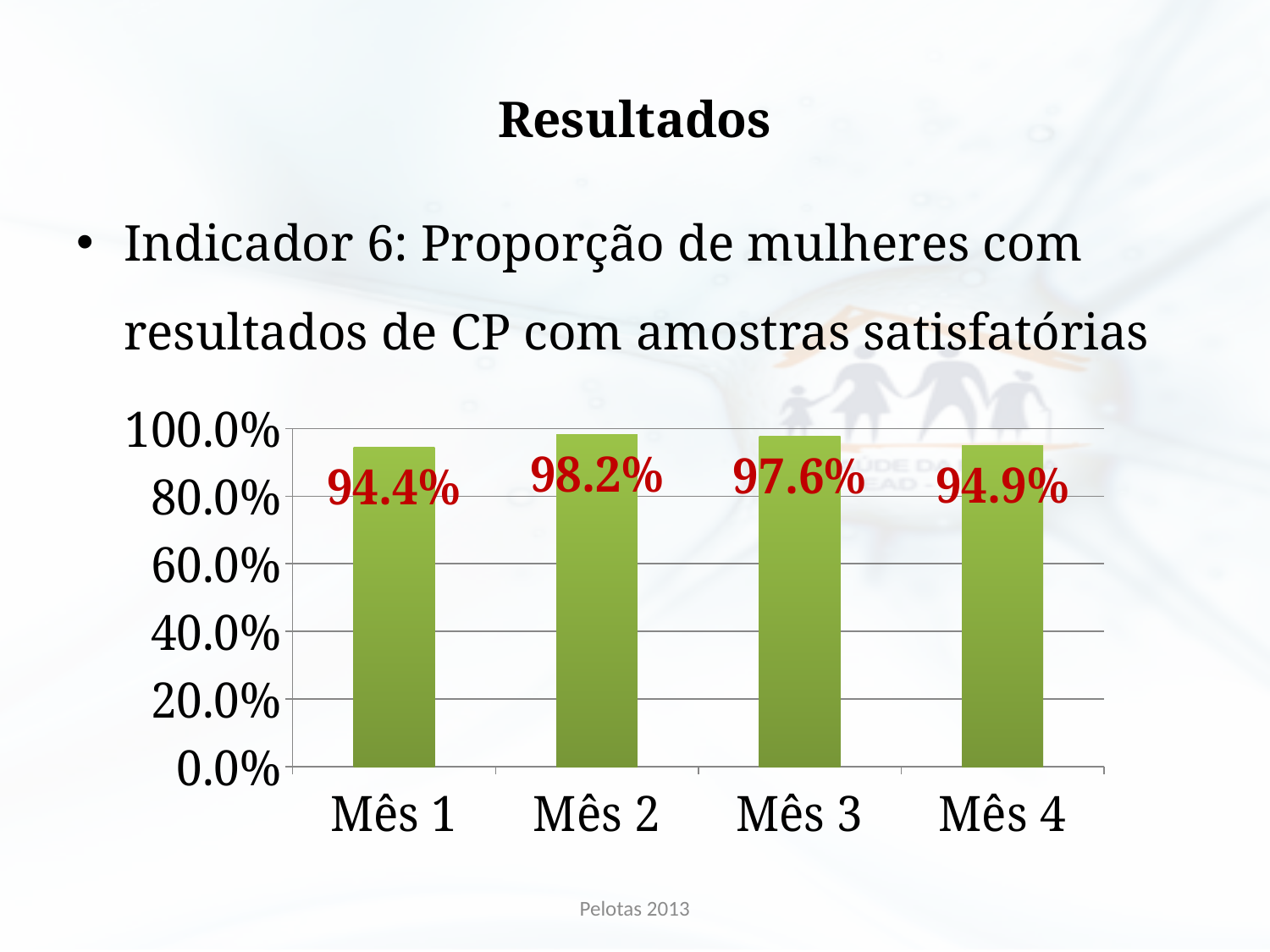
What is the difference between the values for Mês 3 and Mês 4? 2.7% What is the value for Mês 2? 98.2% Which month has the highest value? Mês 2 Is the value for Mês 3 greater or less than 80.0%? greater What is the value for Mês 3? 97.6% What kind of chart is shown on the slide? bar chart What is the value for Mês 4? 94.9% How many months are shown on the x axis? 4 Which month has the lowest value? Mês 1 Which is larger, the value for Mês 2 or the value for Mês 4? Mês 2 What is the difference between the values for Mês 2 and Mês 1? 3.8% What is the value for Mês 1? 94.4%